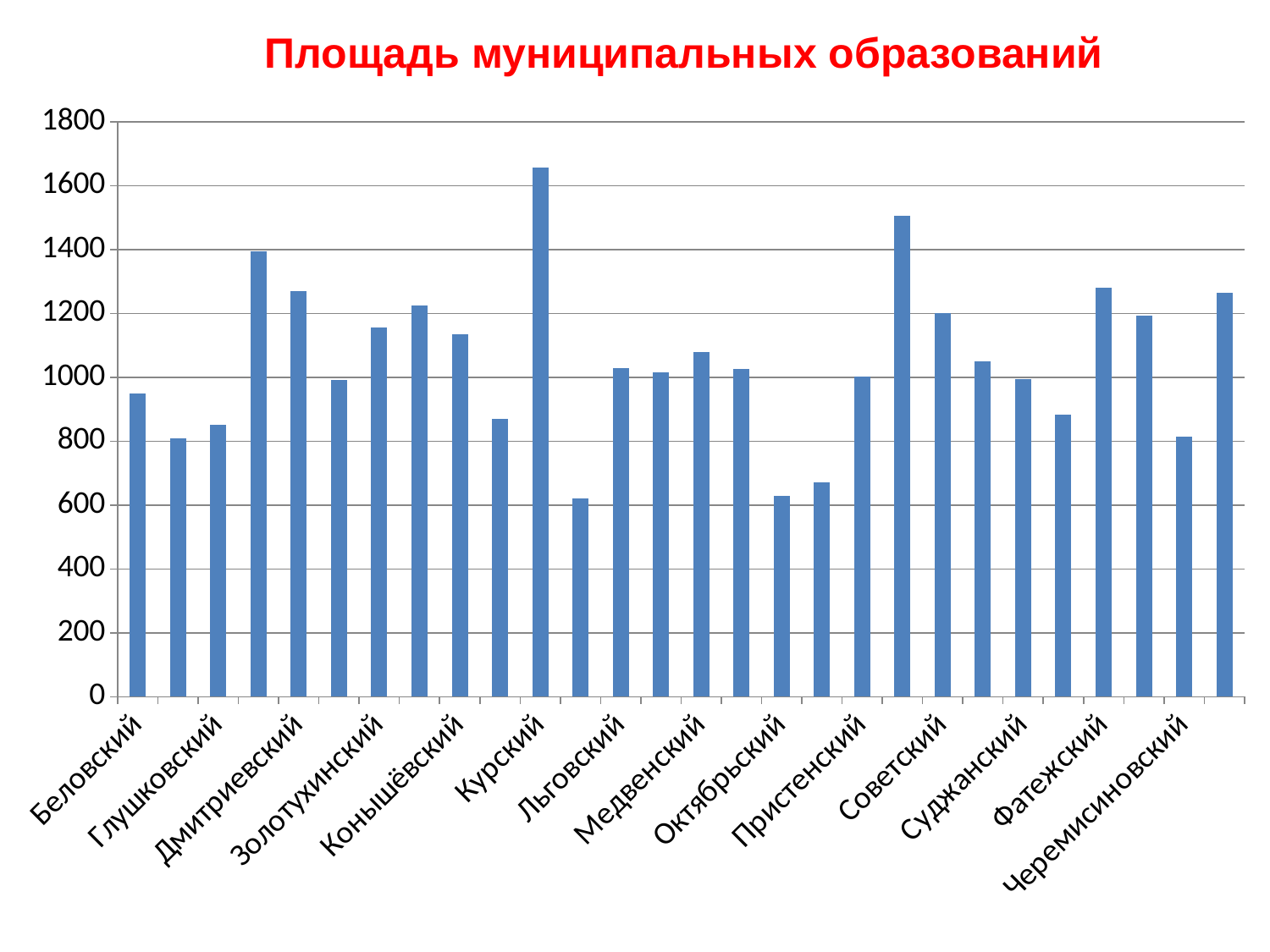
What kind of chart is shown on the slide? bar chart Is the value for Фатежский greater or less than 1200? greater Which is larger, the value for Курский or the value for Беловский? Курский Is the value for Дмитриевский greater or less than 1200? greater Is the value for Беловский greater or less than 1000? less Which labeled category has the highest bar? Курский What is the title of the chart? Площадь муниципальных образований Which is larger, the value for Дмитриевский or the value for Глушковский? Дмитриевский Which is larger, the value for Фатежский or the value for Черемисиновский? Фатежский